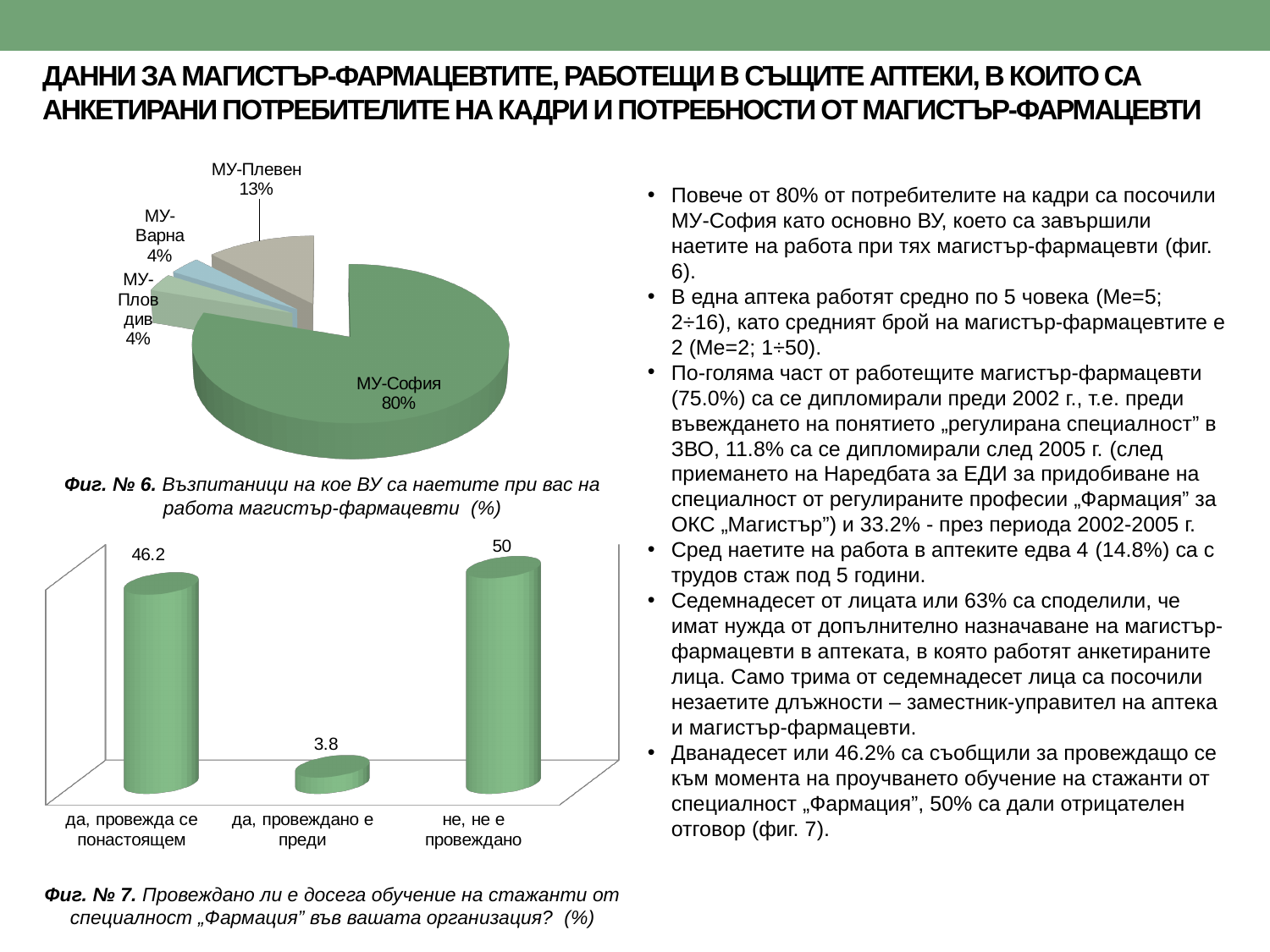
In the pie chart (Фиг. № 6), what share is shown for МУ-София? 80% In the pie chart (Фиг. № 6), what is the difference in percentage points between МУ-София and МУ-Плевен? 67 In the pie chart (Фиг. № 6), how many slices (universities) are shown? 4 In the bar chart (Фиг. № 7), what is the value for 'да, провеждано е преди'? 3.8 In the bar chart (Фиг. № 7), which category has the highest value? не, не е провеждано In the pie chart (Фиг. № 6), which is larger, the share for МУ-Плевен or the share for МУ-Варна? МУ-Плевен What type of chart is Фиг. № 6? Pie chart In the bar chart (Фиг. № 7), what is the difference between the values for 'не, не е провеждано' and 'да, провежда се понастоящем'? 3.8 In the bar chart (Фиг. № 7), what is the value for 'да, провежда се понастоящем'? 46.2 In the bar chart (Фиг. № 7), which category has the lowest value? да, провеждано е преди In the pie chart (Фиг. № 6), what share is shown for МУ-Плевен? 13% In the pie chart (Фиг. № 6), which university has the largest slice? МУ-София